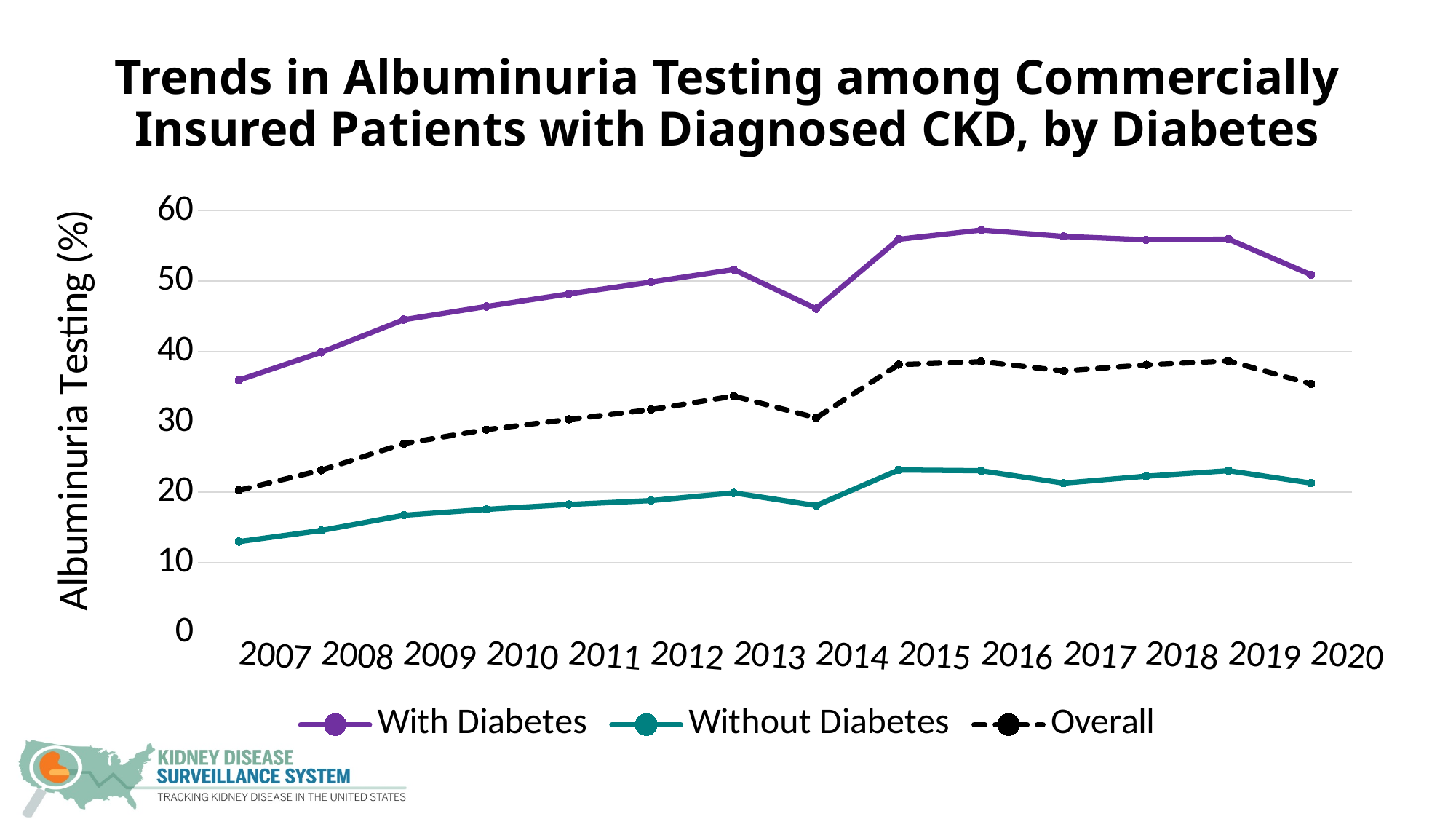
Which series has the highest values across all years? With Diabetes Which series has the lowest values across all years? Without Diabetes What kind of chart is shown on the slide? line chart Is the value for With Diabetes in 2016 greater or less than 50? greater Is the value for Without Diabetes in 2007 greater or less than 20? less How many series does the legend list? 3 Which is larger, the With Diabetes value in 2016 or the With Diabetes value in 2014? 2016 How many years are shown on the x axis? 14 Does the With Diabetes series rise or fall from 2007 to 2013? rise Is the value for With Diabetes in 2007 greater or less than 40? less What is the label of the y axis? Albuminuria Testing (%)